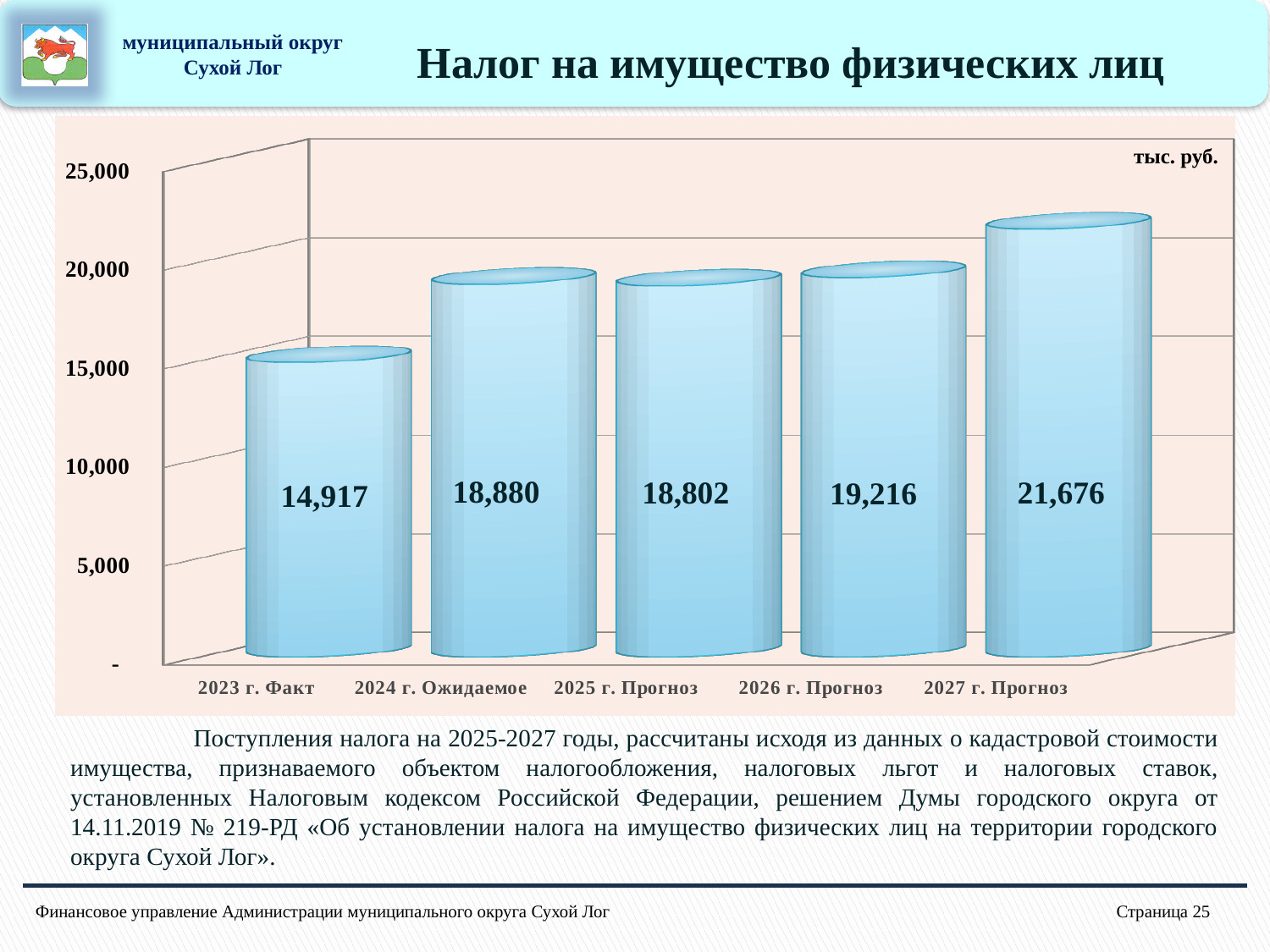
What is the difference between the values for 2026 г. Прогноз and 2025 г. Прогноз? 414 Which is larger, the value for 2024 г. Ожидаемое or 2025 г. Прогноз? 2024 г. Ожидаемое How many categories are shown on the x axis? 5 What unit is indicated in the top right corner of the chart? тыс. руб. Which category has the highest value? 2027 г. Прогноз What kind of chart is shown on the slide? bar chart What is the value for 2027 г. Прогноз? 21,676 Which category has the lowest value? 2023 г. Факт Is the value for 2026 г. Прогноз greater or less than 20,000? less What is the value for 2023 г. Факт? 14,917 What is the value for 2025 г. Прогноз? 18,802 What is the difference between the values for 2027 г. Прогноз and 2023 г. Факт? 6,759